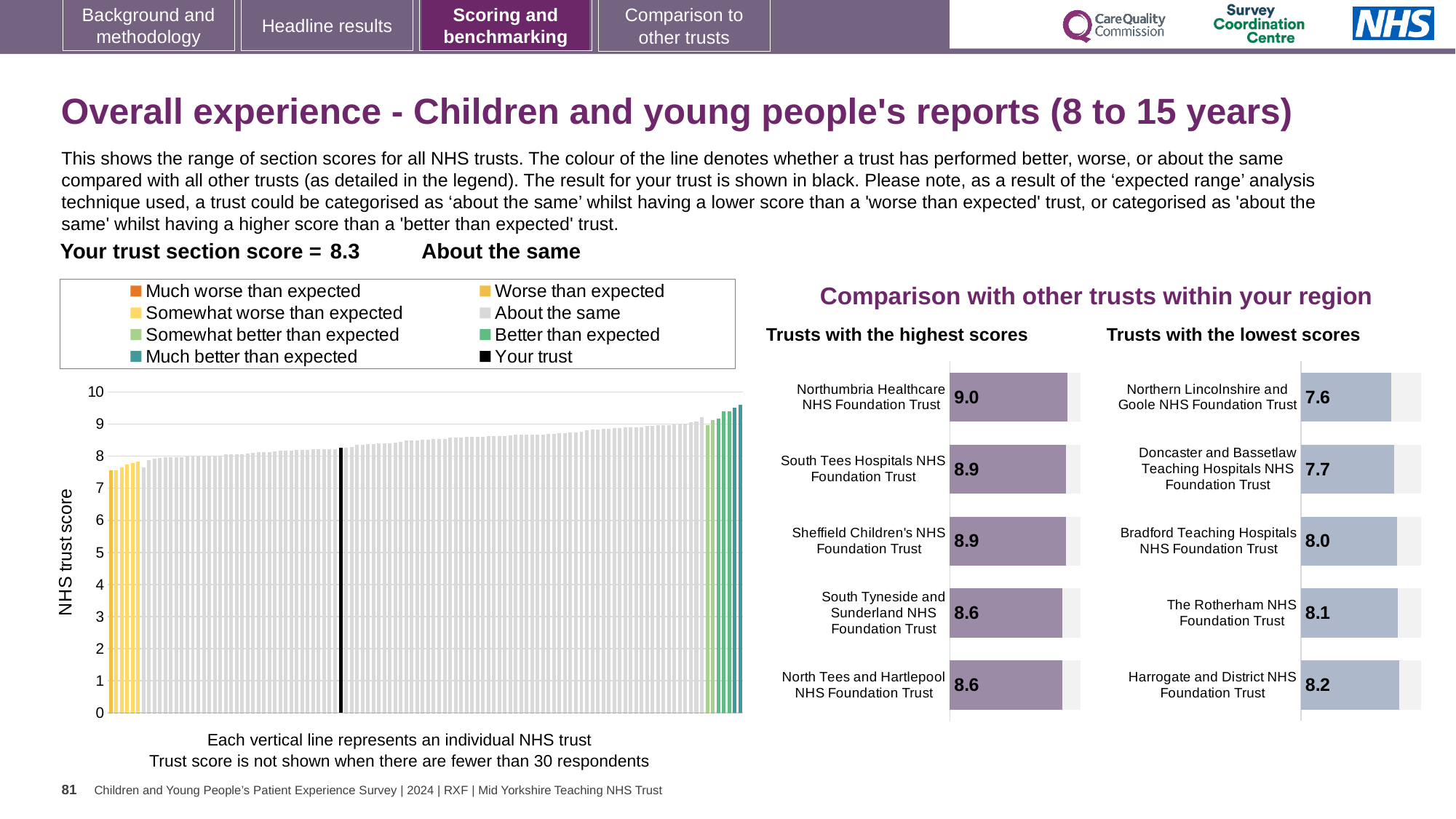
In the 'Trusts with the highest scores' chart, what is the score for Northumbria Healthcare NHS Foundation Trust? 9.0 How many entries does the legend above the large chart on the left list? 8 How many trusts are shown in the 'Trusts with the highest scores' chart? 5 In the 'Trusts with the highest scores' chart, what is the difference between the scores of Northumbria Healthcare NHS Foundation Trust and South Tyneside and Sunderland NHS Foundation Trust? 0.4 In the 'Trusts with the lowest scores' chart, which trust has the lowest score? Northern Lincolnshire and Goole NHS Foundation Trust In the 'Trusts with the highest scores' chart, which trust has the highest score? Northumbria Healthcare NHS Foundation Trust In the 'Trusts with the lowest scores' chart, what is the difference between the scores of Harrogate and District NHS Foundation Trust and Northern Lincolnshire and Goole NHS Foundation Trust? 0.6 In the 'Trusts with the lowest scores' chart, which has the higher score: The Rotherham NHS Foundation Trust or Bradford Teaching Hospitals NHS Foundation Trust? The Rotherham NHS Foundation Trust In the large chart on the left showing the range of section scores, is the value for your trust (the black line) greater or less than 5? greater In the 'Trusts with the lowest scores' chart, what is the score for Bradford Teaching Hospitals NHS Foundation Trust? 8.0 What kind of chart is the large chart on the left showing the range of section scores for all NHS trusts? bar chart In the large chart on the left, do the trust scores rise or fall from left to right along the x axis? rise